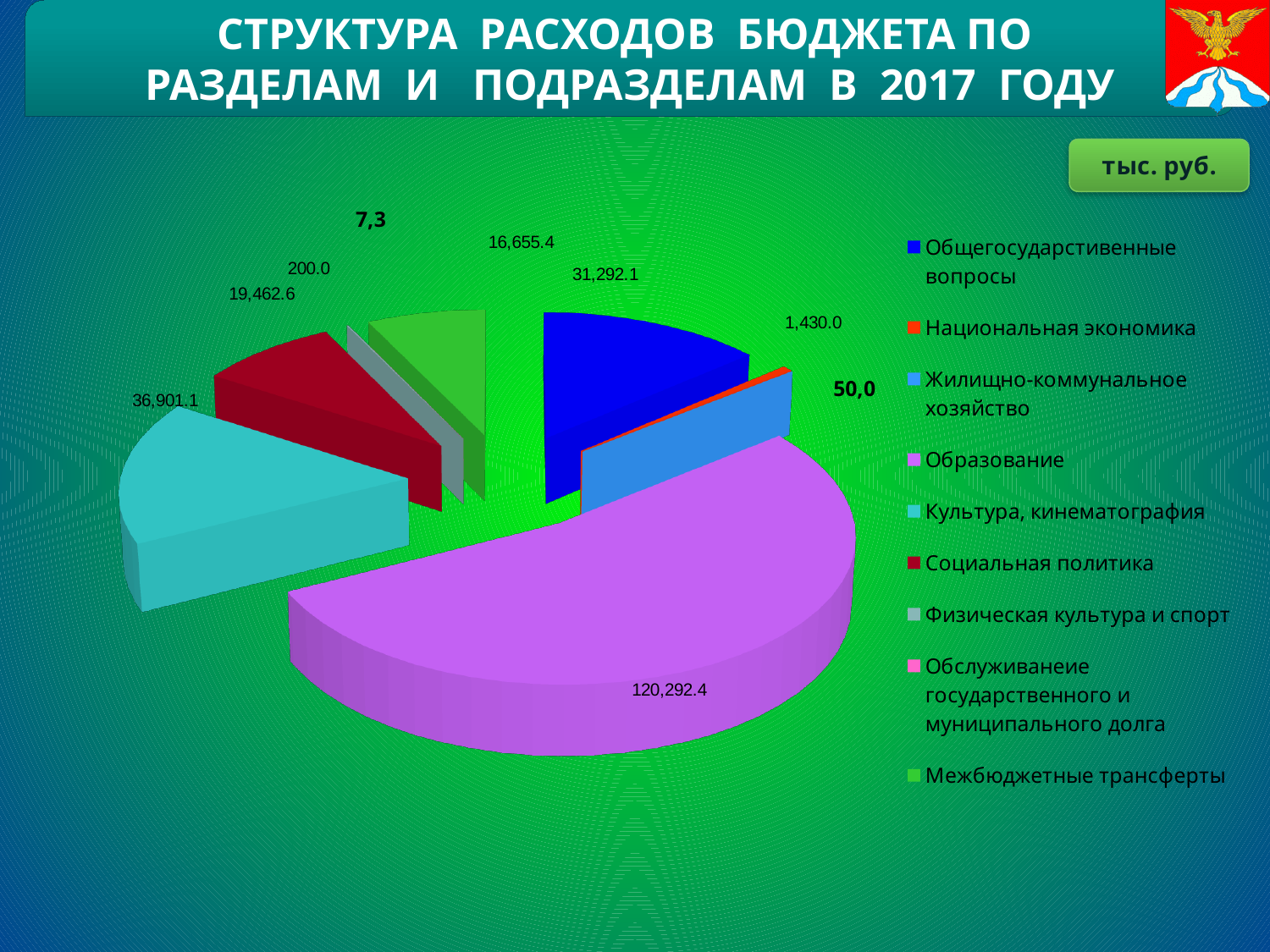
What is the value for Социальная политика? 19,462.6 What is the value for Культура, кинематография? 36,901.1 In what units are the values on the chart given, according to the label in the top right? тыс. руб. What is the value for Межбюджетные трансферты? 16,655.4 Which category has the largest slice of the pie? Образование What is the difference between Культура, кинематография and Общегосударственные вопросы? 5,609.0 What is the difference between Социальная политика and Межбюджетные трансферты? 2,807.2 Which is larger, Культура, кинематография or Общегосударственные вопросы? Культура, кинематография What is the value for Образование? 120,292.4 What is the value for Общегосударственные вопросы? 31,292.1 How many categories does the legend of the pie chart list? 9 What kind of chart is shown on the slide? pie chart